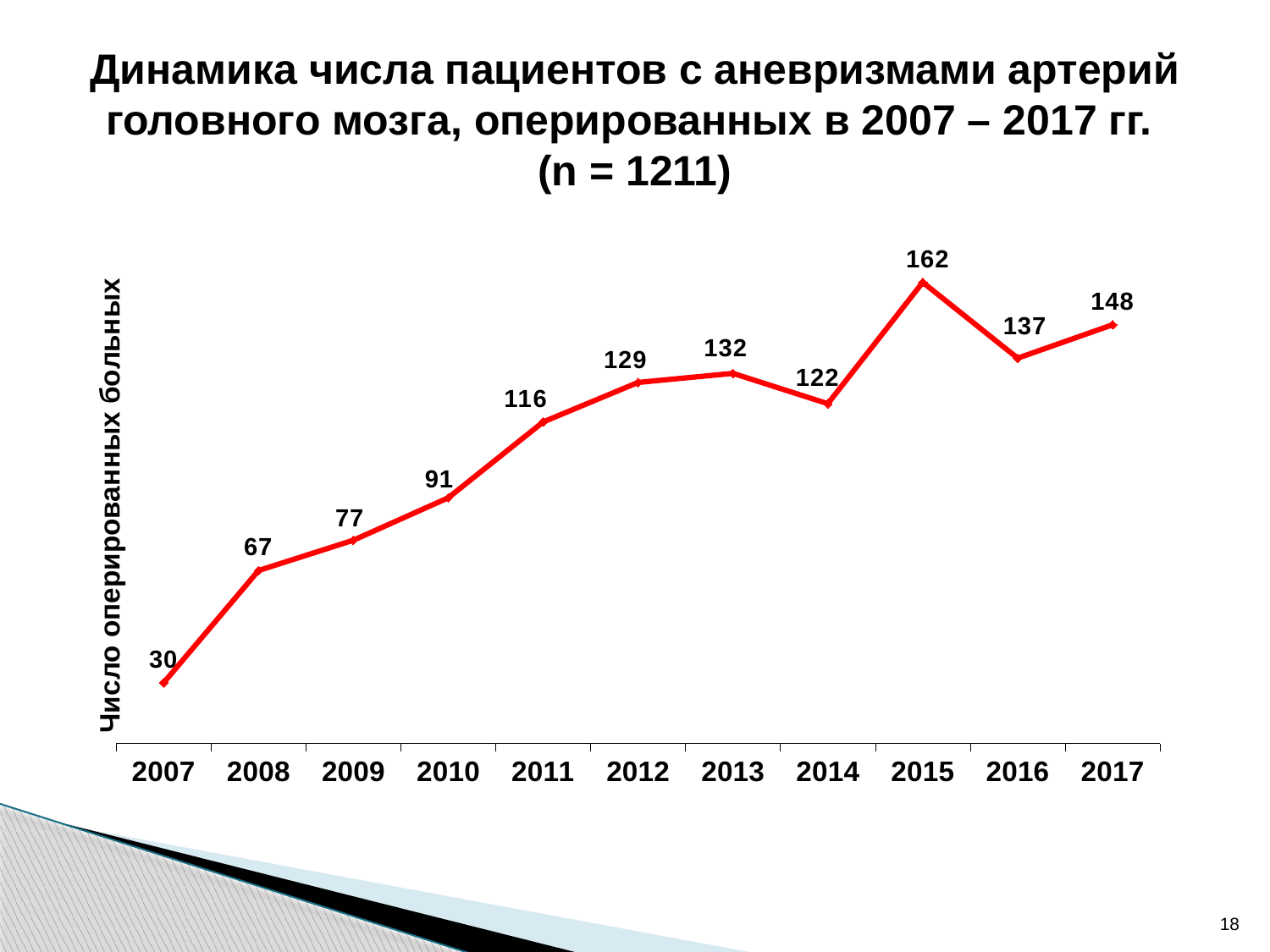
Which year has a larger value, 2013 or 2016? 2016 What is the difference between the values for 2015 and 2014? 40 What is the difference between the values for 2008 and 2007? 37 Which year has the highest number of operated patients? 2015 Which year has the lowest number of operated patients? 2007 What is the value for 2011? 116 What type of chart is shown on the slide? line chart What is the value for 2017? 148 How many operated patients are shown for 2007? 30 How many years (data points) are plotted on the chart? 11 What is the label of the vertical axis? Число оперированных больных Do the values generally rise or fall from 2007 to 2017? rise